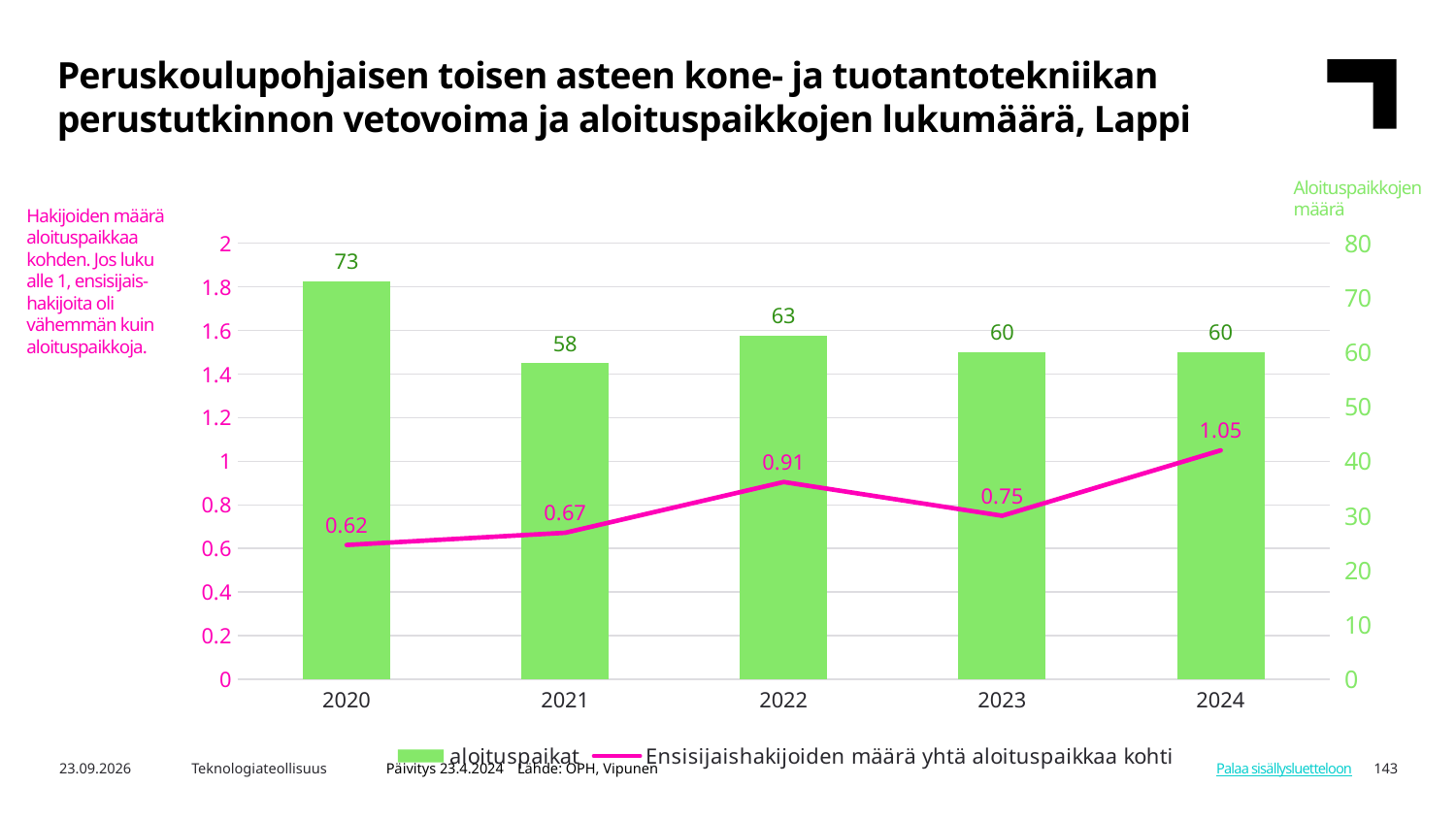
Does the Ensisijaishakijoiden määrä yhtä aloituspaikkaa kohti value rise or fall from 2023 to 2024? rise What kind of chart is used for the aloituspaikat series? bar chart How many series does the legend list? 2 How many years are shown on the x axis? 5 Which year has the lowest value of aloituspaikat? 2021 What is the value of Ensisijaishakijoiden määrä yhtä aloituspaikkaa kohti for 2022? 0.91 Which is larger, the Ensisijaishakijoiden määrä yhtä aloituspaikkaa kohti value for 2022 or for 2023? 2022 Which year has the highest value of aloituspaikat? 2020 What is the value of aloituspaikat for 2020? 73 What is the difference in aloituspaikat between 2020 and 2021? 15 What is the value of Ensisijaishakijoiden määrä yhtä aloituspaikkaa kohti for 2024? 1.05 Which year has the lowest value of Ensisijaishakijoiden määrä yhtä aloituspaikkaa kohti? 2020